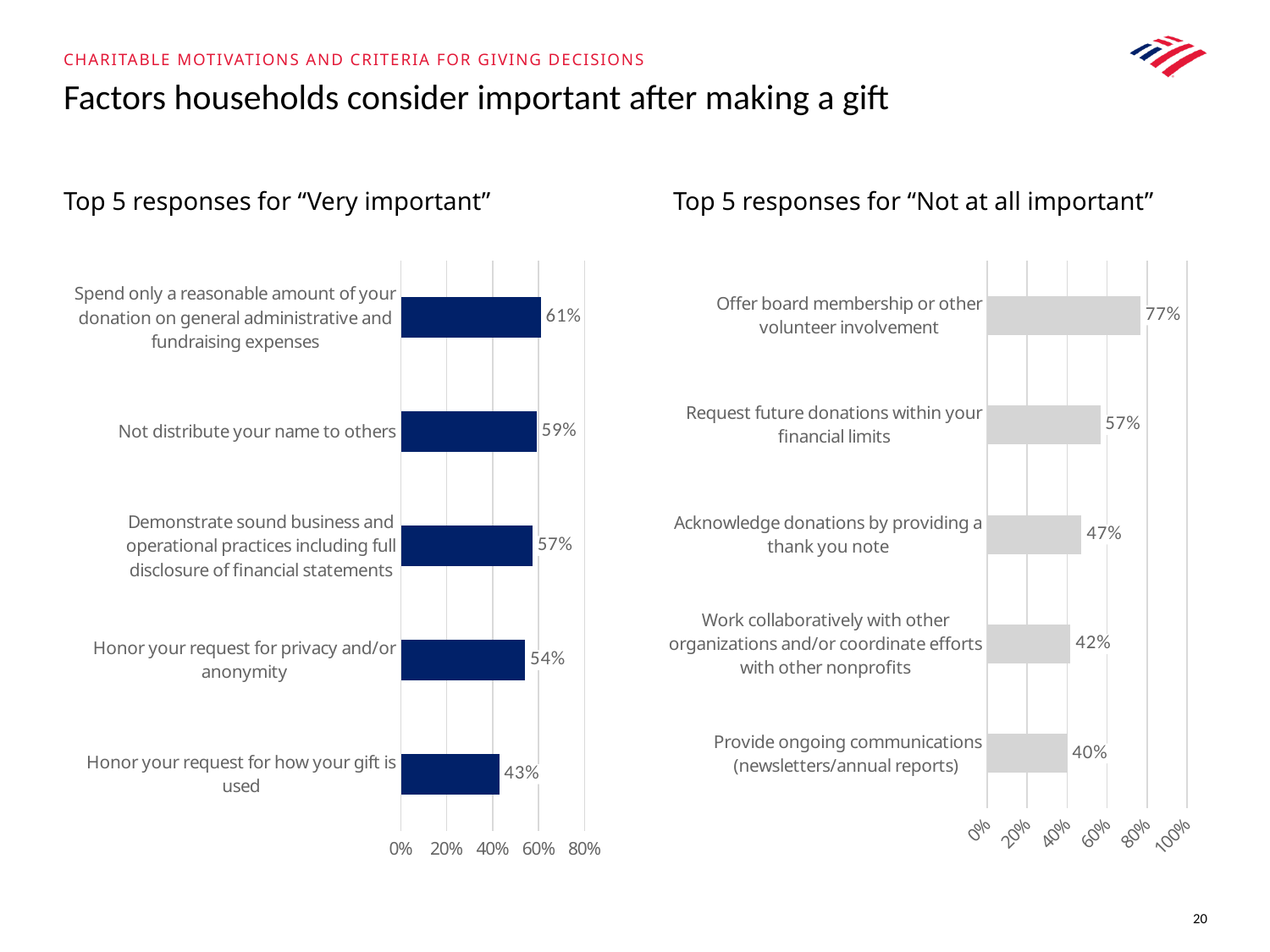
What kind of chart is the "Top 5 responses for 'Very important'" chart? Bar chart In the "Top 5 responses for 'Very important'" chart, which category has the highest value? Spend only a reasonable amount of your donation on general administrative and fundraising expenses In the "Top 5 responses for 'Not at all important'" chart, which category has the lowest value? Provide ongoing communications (newsletters/annual reports) In the "Top 5 responses for 'Not at all important'" chart, which is larger: the value for "Work collaboratively with other organizations and/or coordinate efforts with other nonprofits" or the value for "Provide ongoing communications (newsletters/annual reports)"? Work collaboratively with other organizations and/or coordinate efforts with other nonprofits What is the title of the chart on the right side of the slide? Top 5 responses for "Not at all important" In the "Top 5 responses for 'Very important'" chart, what is the value for "Demonstrate sound business and operational practices including full disclosure of financial statements"? 57% In the "Top 5 responses for 'Not at all important'" chart, what is the difference between the values for "Offer board membership or other volunteer involvement" and "Request future donations within your financial limits"? 20% In the "Top 5 responses for 'Not at all important'" chart, what is the value for "Acknowledge donations by providing a thank you note"? 47% In the "Top 5 responses for 'Very important'" chart, is the value for "Honor your request for privacy and/or anonymity" greater or less than 40%? greater In the "Top 5 responses for 'Very important'" chart, what is the value for "Not distribute your name to others"? 59% How many categories are shown in the "Top 5 responses for 'Not at all important'" chart? 5 In the "Top 5 responses for 'Very important'" chart, what is the difference between the values for "Spend only a reasonable amount of your donation on general administrative and fundraising expenses" and "Honor your request for how your gift is used"? 18%